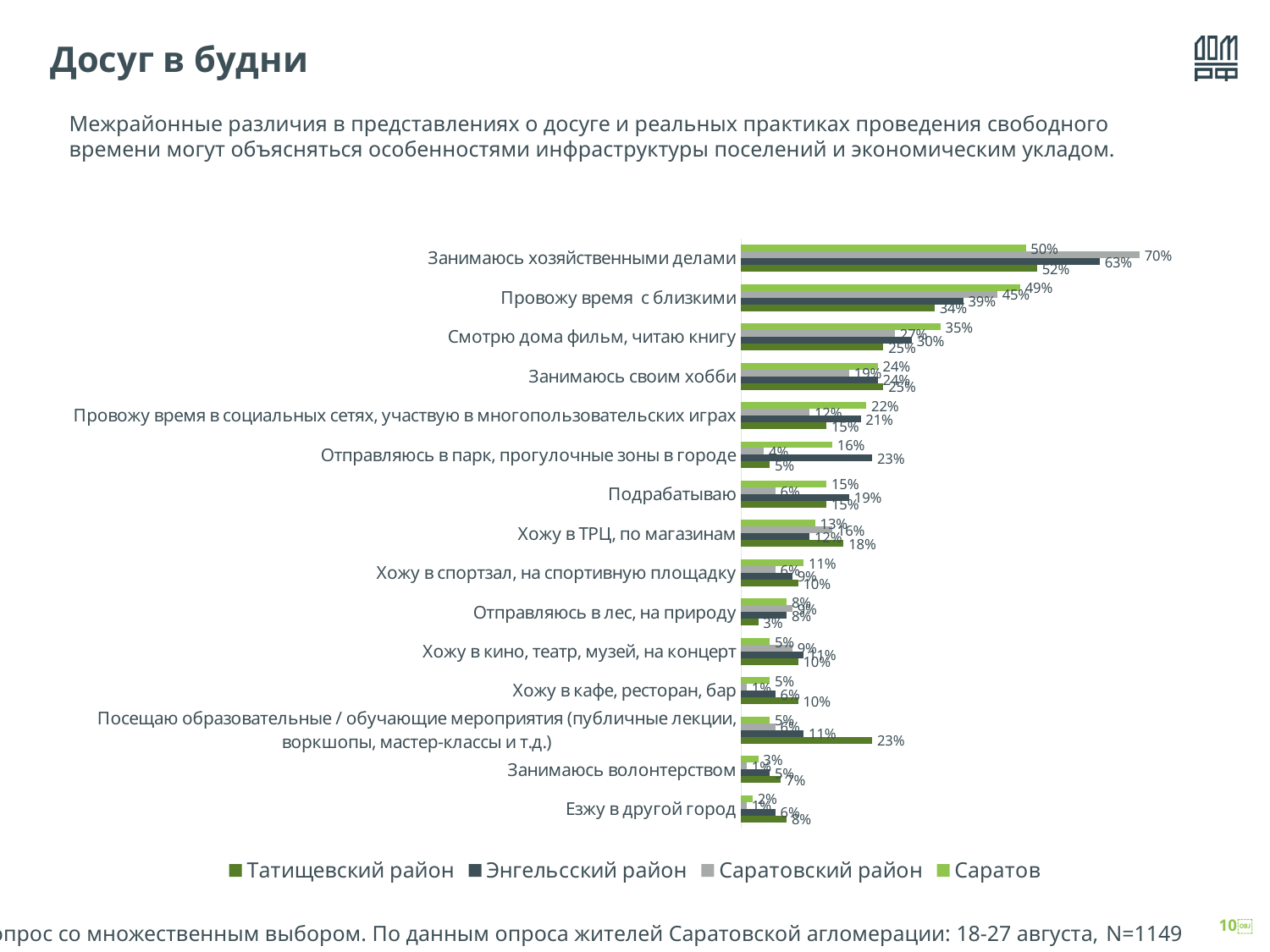
What is the value for Саратовский район for 'Занимаюсь хозяйственными делами'? 70% Which district has the lowest value for 'Провожу время с близкими'? Татищевский район Which district has the highest value for 'Занимаюсь хозяйственными делами'? Саратовский район Which series is shown in light green in the legend? Саратов What kind of chart is shown on the slide? bar chart What is the difference between Саратовский район (70%) and Энгельсский район (63%) for 'Занимаюсь хозяйственными делами'? 7 percentage points How many series does the legend list? 4 What is the value for Саратов for 'Провожу время с близкими'? 49% What is the value for Энгельсский район for 'Отправляюсь в парк, прогулочные зоны в городе'? 23% For 'Отправляюсь в парк, прогулочные зоны в городе', which is larger: the value for Энгельсский район or for Саратов? Энгельсский район How many leisure activity categories are plotted on the chart? 15 What is the value for Татищевский район for 'Посещаю образовательные / обучающие мероприятия'? 23%